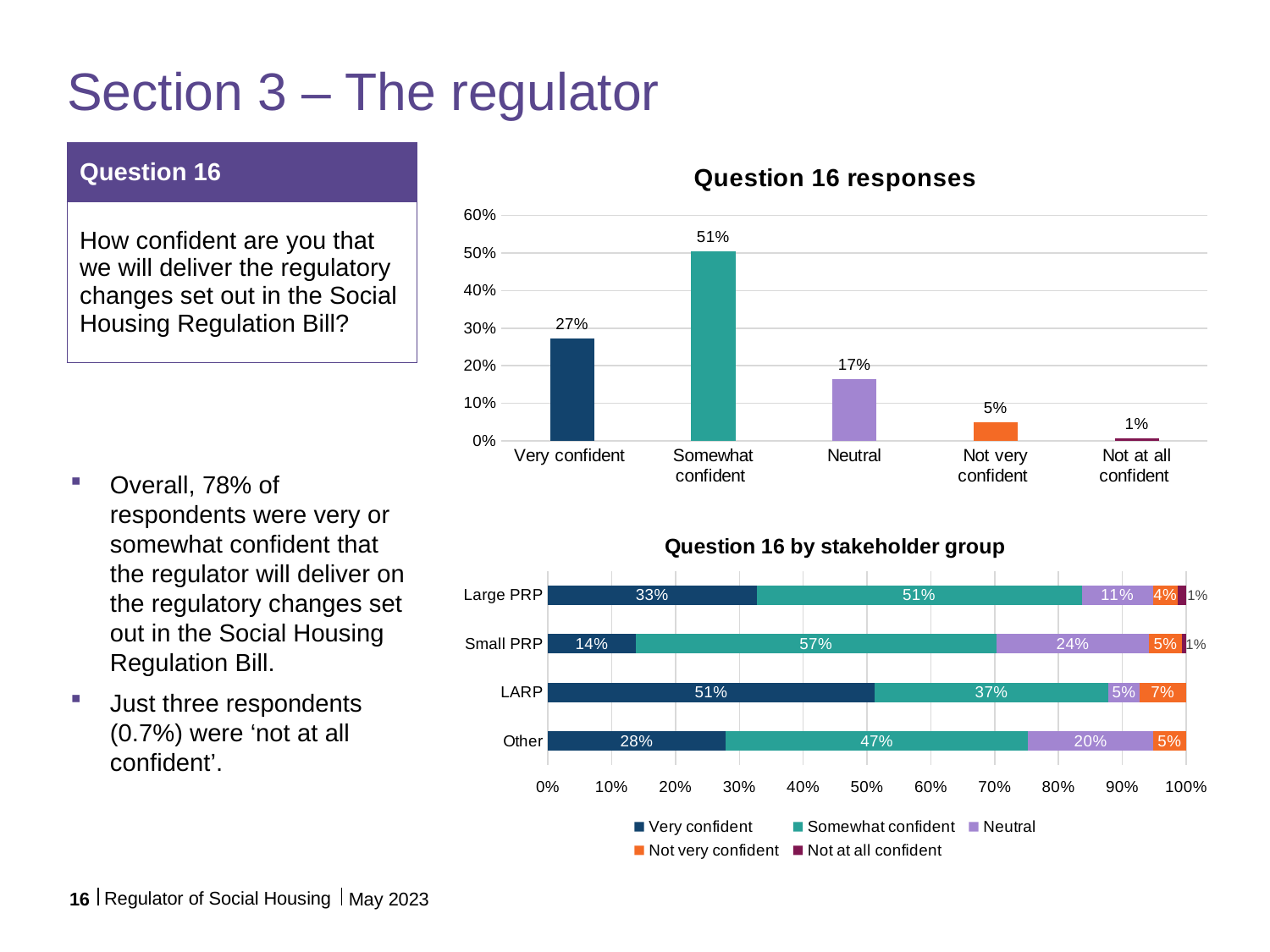
In the 'Question 16 by stakeholder group' chart, what percentage of LARP respondents were very confident? 51% In the 'Question 16 responses' chart, what is the difference between the Very confident and Neutral values? 10% In the 'Question 16 responses' chart, how many response categories are shown on the x axis? 5 What kind of chart is 'Question 16 responses'? Bar chart In the 'Question 16 by stakeholder group' chart, which stakeholder group has the highest Very confident share? LARP How many series does the legend of the 'Question 16 by stakeholder group' chart list? 5 In the 'Question 16 responses' chart, which response category has the lowest value? Not at all confident In the 'Question 16 responses' chart, what percentage of respondents were somewhat confident? 51% In the 'Question 16 by stakeholder group' chart, is the Somewhat confident share larger for Small PRP or for Other? Small PRP In the 'Question 16 responses' chart, which response category has the highest value? Somewhat confident In the 'Question 16 by stakeholder group' chart, what percentage of Small PRP respondents were neutral? 24% In the 'Question 16 by stakeholder group' chart, how many stakeholder groups are shown? 4